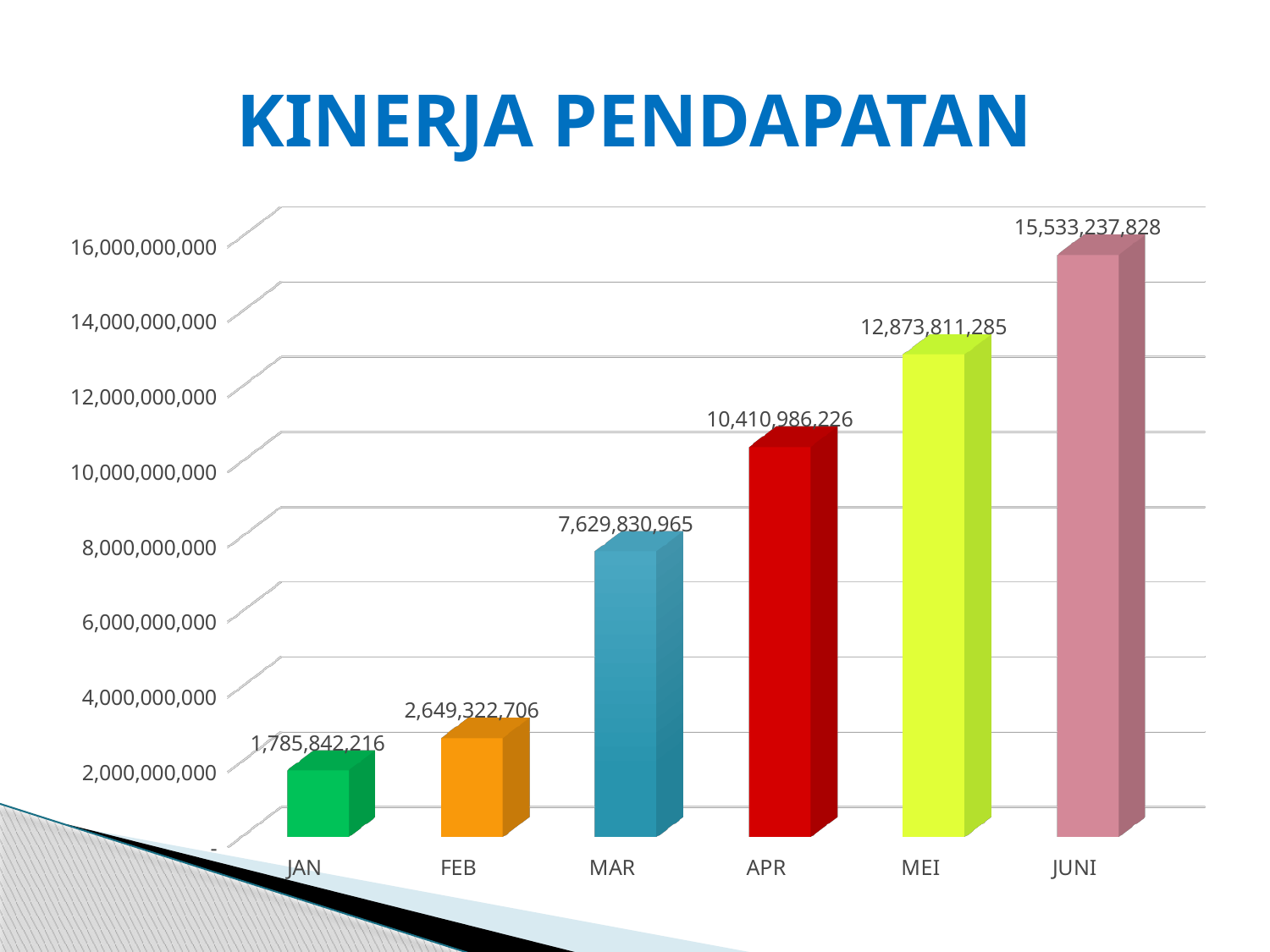
Which month has the highest value? JUNI Which is larger, the value for FEB or the value for MAR? MAR How many months are shown on the chart? 6 What is the difference between the values for APR and MAR? 2,781,155,261 What is the value for JUNI? 15,533,237,828 What is the difference between the values for JUNI and MEI? 2,659,426,543 Which month has the lowest value? JAN Is the value for MEI greater or less than 12,000,000,000? greater What is the value for JAN? 1,785,842,216 What is the value for MAR? 7,629,830,965 What kind of chart is shown on the slide? Bar chart Do the values rise or fall from JAN to JUNI? Rise